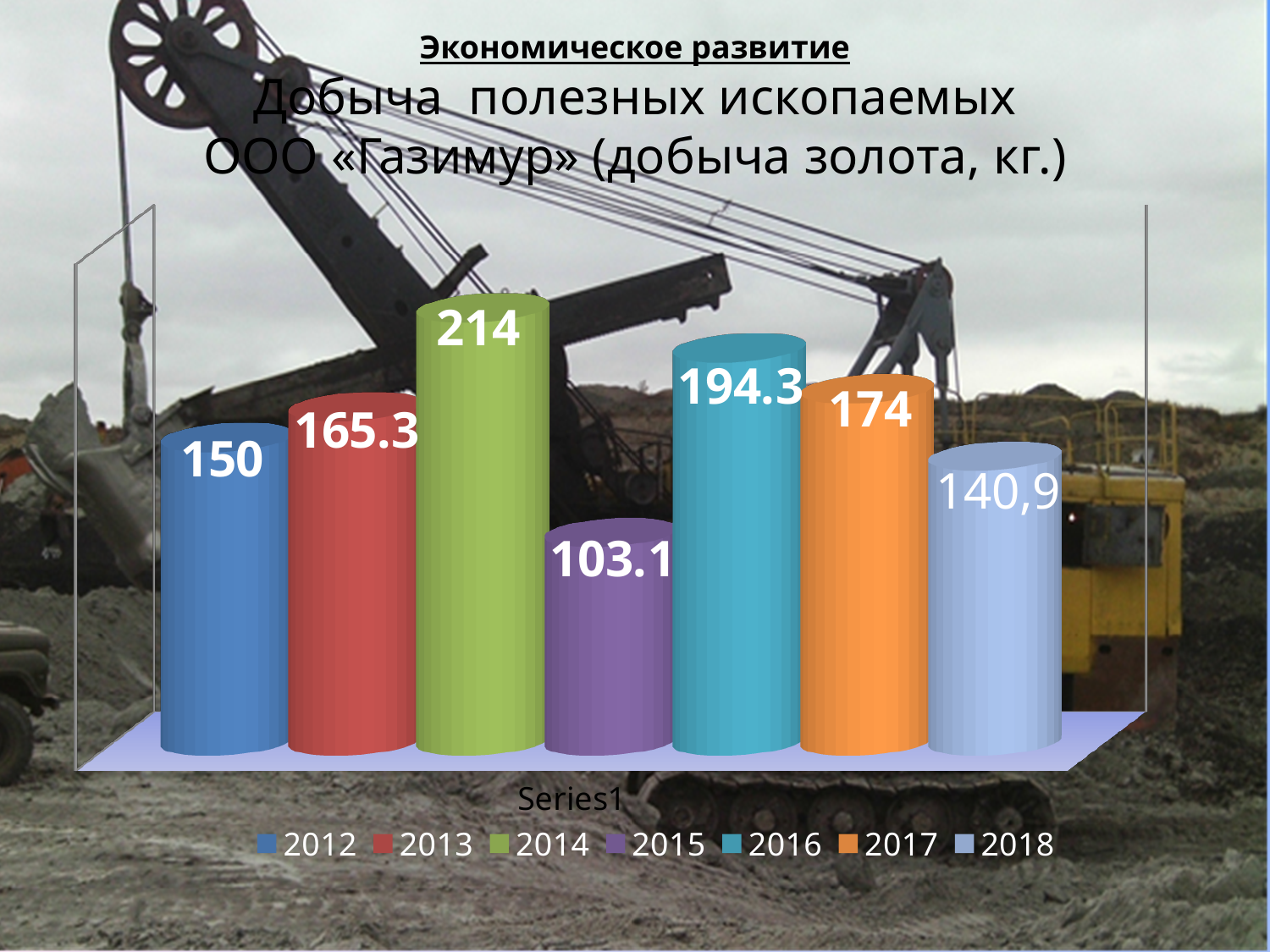
What kind of chart is shown on the slide? bar chart What value is shown for 2018? 140,9 What is the value shown for 2015? 103.1 What is the value shown for 2016? 194.3 What is the difference between the values for 2013 and 2012? 15.3 What is the difference between the values for 2014 and 2015? 110.9 Which year has the lowest value on the chart? 2015 What colour is the bar for 2014? green What is the gold production value shown for 2014? 214 Which is larger, the value for 2016 or the value for 2017? 2016 Which year has the highest value on the chart? 2014 How many years does the legend list? 7